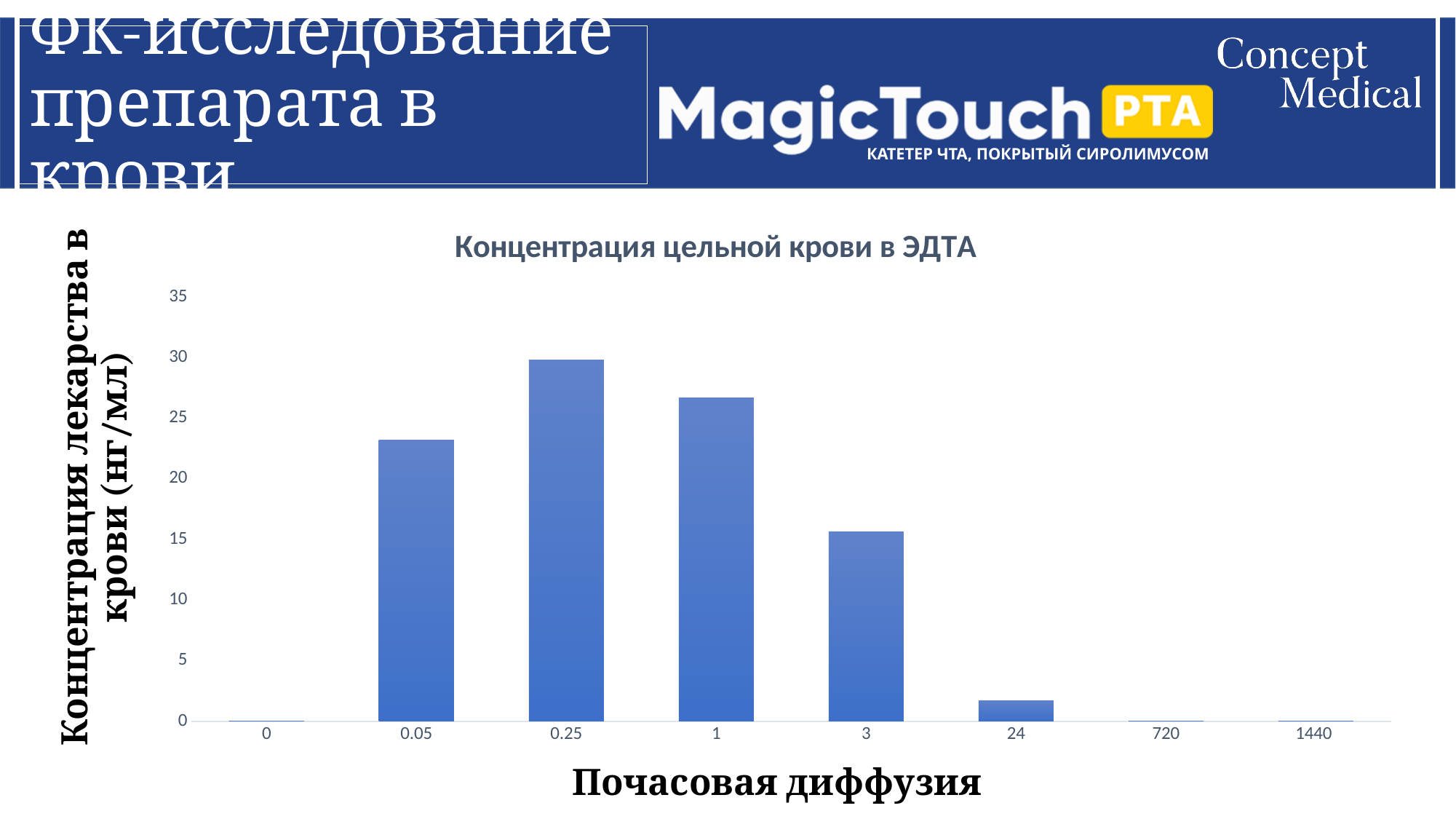
Is the value for 0.25 greater or less than 25? greater What is the label of the x axis? Почасовая диффузия What is the title of the chart? Концентрация цельной крови в ЭДТА What kind of chart is shown on the slide? bar chart Which category has the highest bar? 0.25 Is the value for 3 greater or less than 20? less Is the value for 0.05 greater or less than 20? greater Which has the larger value, 3 or 24? 3 How many categories are shown on the x axis? 8 Which has the larger value, 0.05 or 1? 1